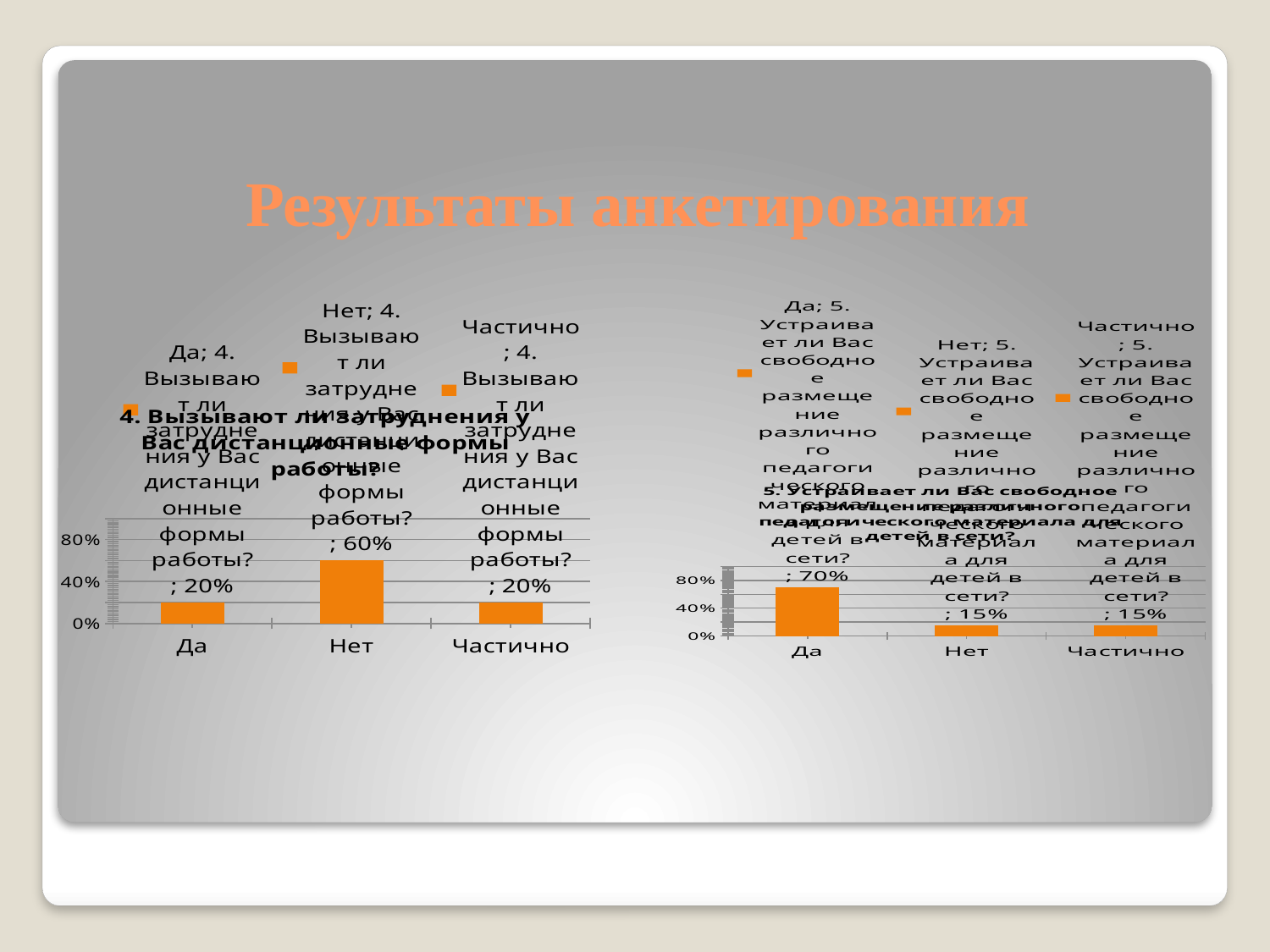
In the left chart, what is the value for Да? 20% In the left chart, what is the value for Нет? 60% In the right chart, which category has the highest value? Да What is the title of the slide? Результаты анкетирования In the right chart, what is the difference between the values for Да and Нет? 55% What type of chart is the right chart? bar chart In the right chart, what is the value for Частично? 15% In the left chart, which category has the highest value? Нет In the right chart, what is the value for Да? 70% How many categories does the left chart show? 3 In the left chart, what is the difference between the values for Нет and Да? 40% In the right chart, which is larger, the value for Да or the value for Нет? Да